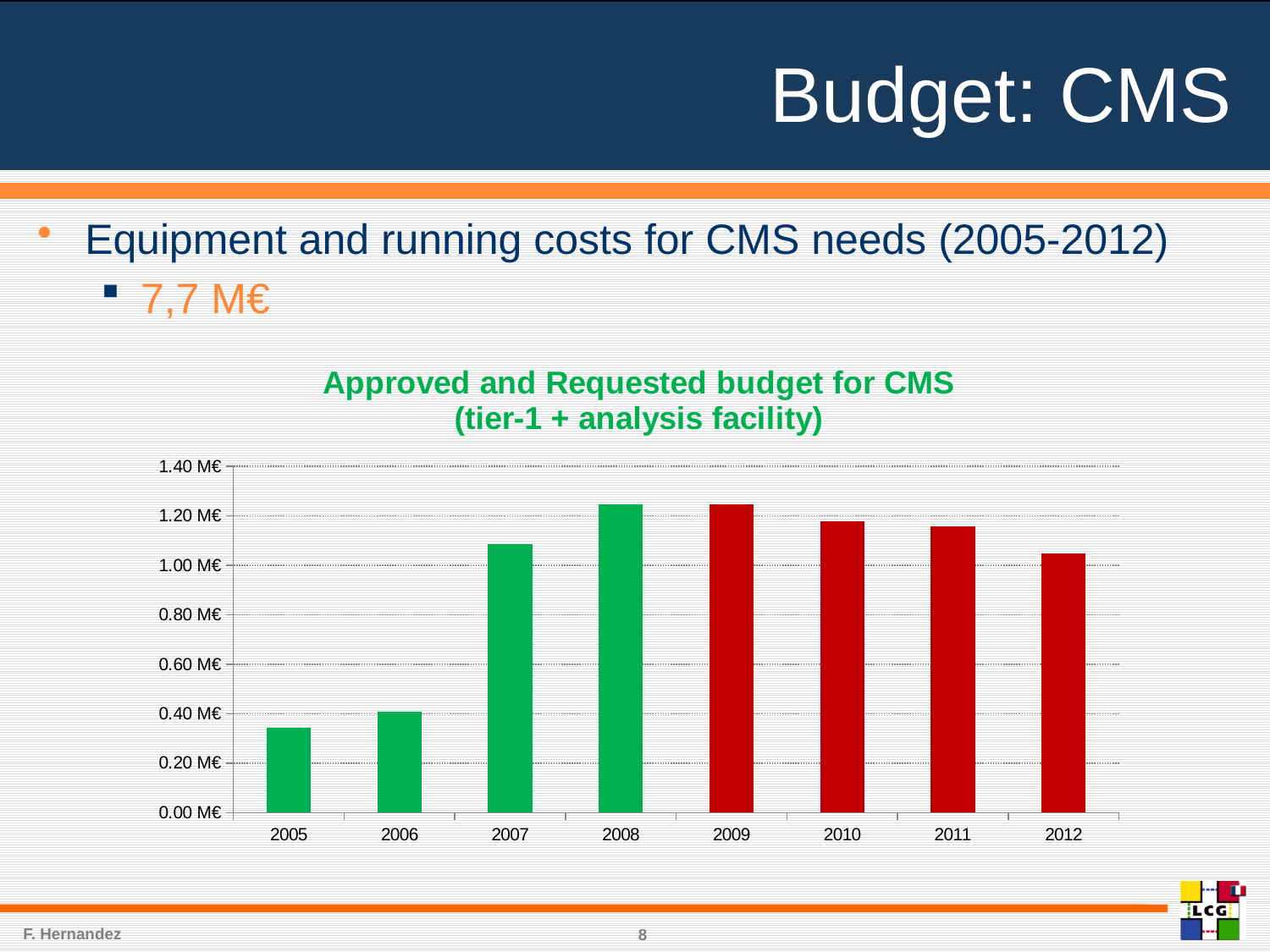
Is the value for 2005 greater or less than 0.40 M€? less What kind of chart is shown on the slide? bar chart Is the value for 2012 greater or less than 1.20 M€? less Is the value for 2010 greater or less than 1.20 M€? less Which year has the lowest budget in the chart? 2005 Do the values rise or fall from 2005 to 2008? rise Which year has the larger budget, 2007 or 2008? 2008 Which year has the larger budget, 2010 or 2012? 2010 What is the title of the chart? Approved and Requested budget for CMS (tier-1 + analysis facility) How many years are shown on the x axis of the chart? 8